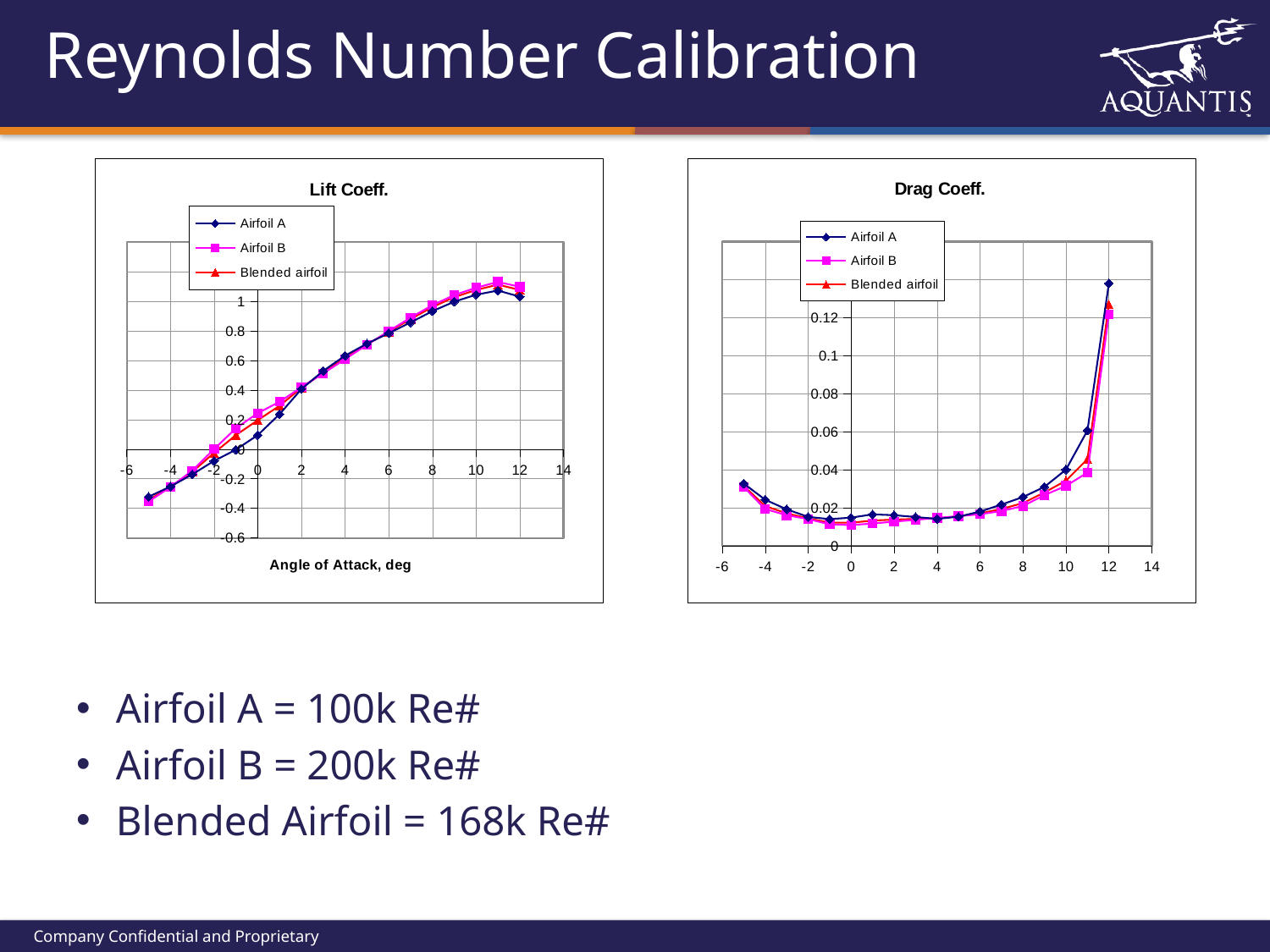
In the Drag Coeff. chart, is the value for Airfoil A at 0 degrees greater or less than 0.02? less In the Drag Coeff. chart, at which angle of attack does Airfoil A reach its highest value? 12 In the Lift Coeff. chart, is the value for Airfoil A at 8 degrees greater or less than 0.8? greater How many series does the legend of the Drag Coeff. chart list? 3 In the Lift Coeff. chart, at 0 degrees, which series has the larger value, Airfoil A or Airfoil B? Airfoil B In the Drag Coeff. chart, is the value for Airfoil A at 12 degrees greater or less than 0.12? greater What is the x-axis title of the Lift Coeff. chart? Angle of Attack, deg What kind of chart is the Lift Coeff. chart? line chart In the Drag Coeff. chart, at 11 degrees, which series has the larger value, Airfoil A or Airfoil B? Airfoil A In the Lift Coeff. chart, do the values generally rise or fall as the angle of attack increases from -5 to 10 degrees? rise In the Lift Coeff. chart, which series is drawn in magenta with square markers? Airfoil B